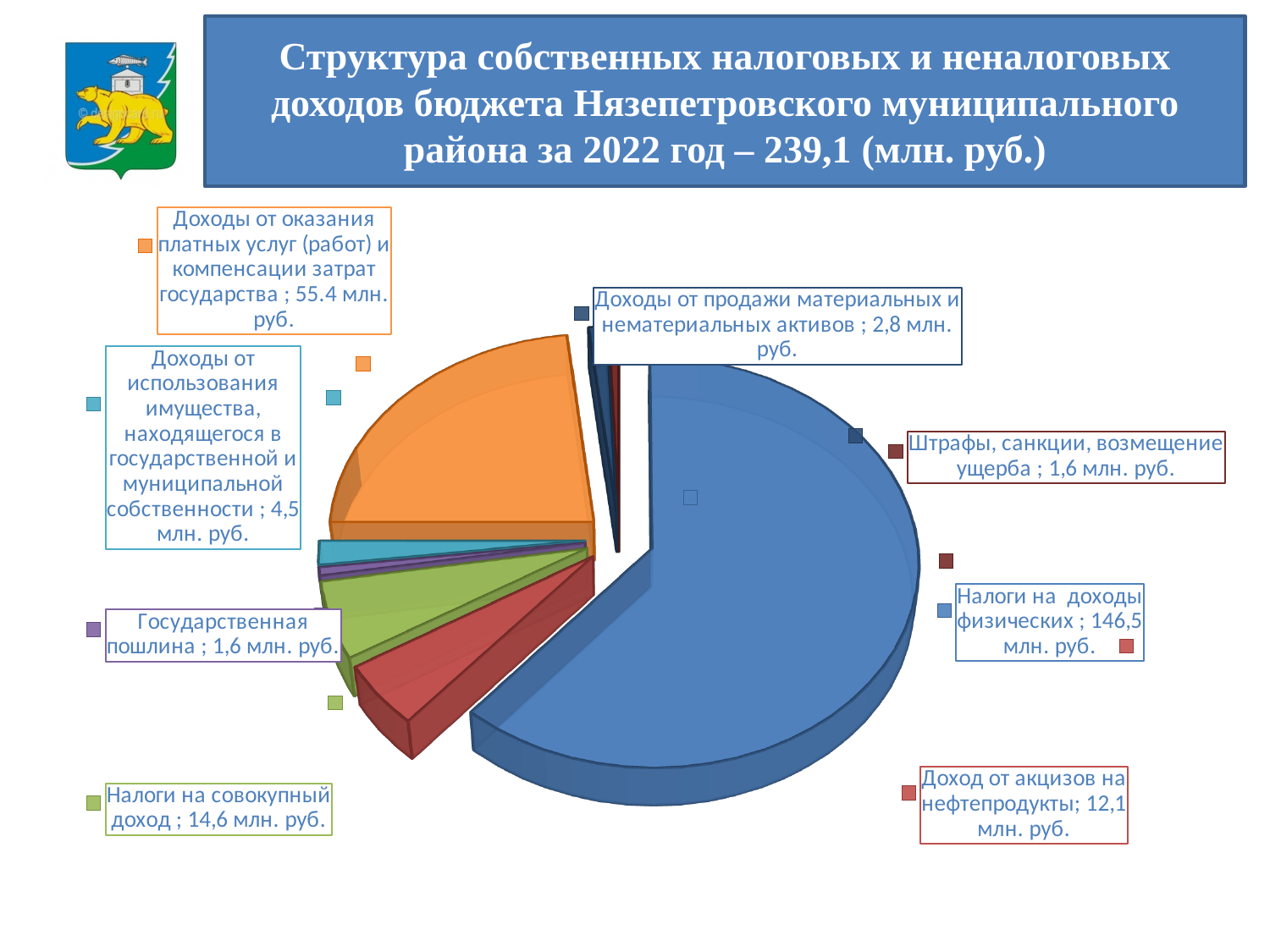
What is the value for Доходы от оказания платных услуг (работ) и компенсации затрат государства? 55.4 млн. руб. What is the value for Налоги на совокупный доход? 14,6 млн. руб. Which is larger: Доходы от использования имущества or Доходы от продажи материальных и нематериальных активов? Доходы от использования имущества What is the value for Доход от акцизов на нефтепродукты? 12,1 млн. руб. What is the difference between Налоги на совокупный доход and Доход от акцизов на нефтепродукты? 2,5 млн. руб. What is the value for Доходы от продажи материальных и нематериальных активов? 2,8 млн. руб. What is the value for Налоги на доходы физических? 146,5 млн. руб. Which category has the largest slice of the pie? Налоги на доходы физических How many categories are shown in the pie chart? 8 What is the difference between Налоги на доходы физических and Доходы от оказания платных услуг (работ) и компенсации затрат государства? 91,1 млн. руб. What type of chart is shown on the slide? pie chart What total amount in млн. руб. is stated in the chart title for 2022? 239,1